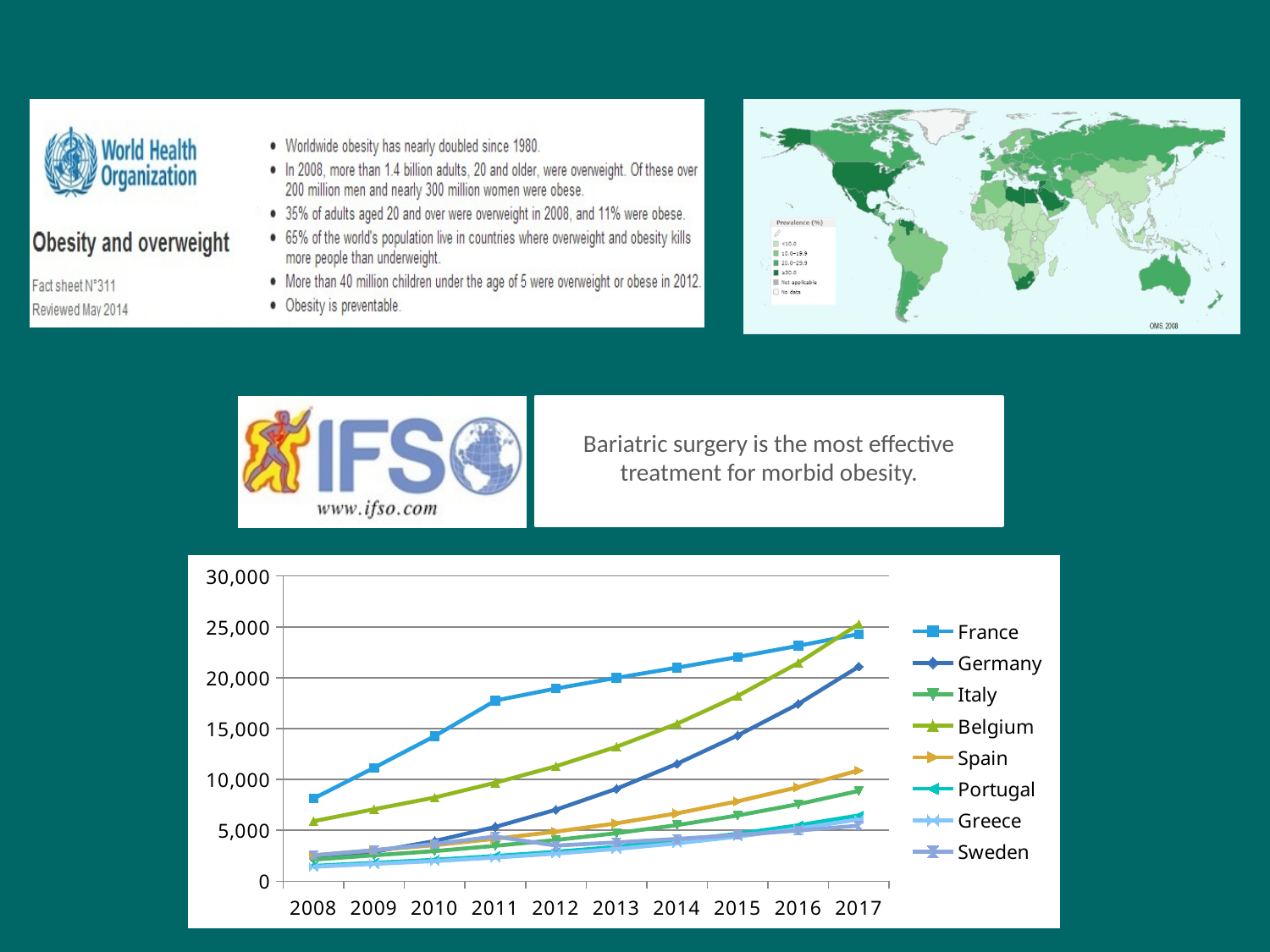
In 2013, which is larger on the line chart: Germany or Belgium? Belgium Is the value for France in 2012 greater or less than 15,000? greater Is the value for Italy in 2017 greater or less than 10,000? less Which country has the highest value in 2012 on the line chart? France Is the value for Germany in 2016 greater or less than 15,000? greater What kind of chart is shown at the bottom of the slide? line chart Which country has the highest value in 2008 on the line chart? France How many years are shown on the x axis of the line chart? 10 In 2014, which is larger on the line chart: France or Belgium? France How many series does the legend of the line chart list? 8 Does the value for France rise or fall from 2008 to 2017? rise